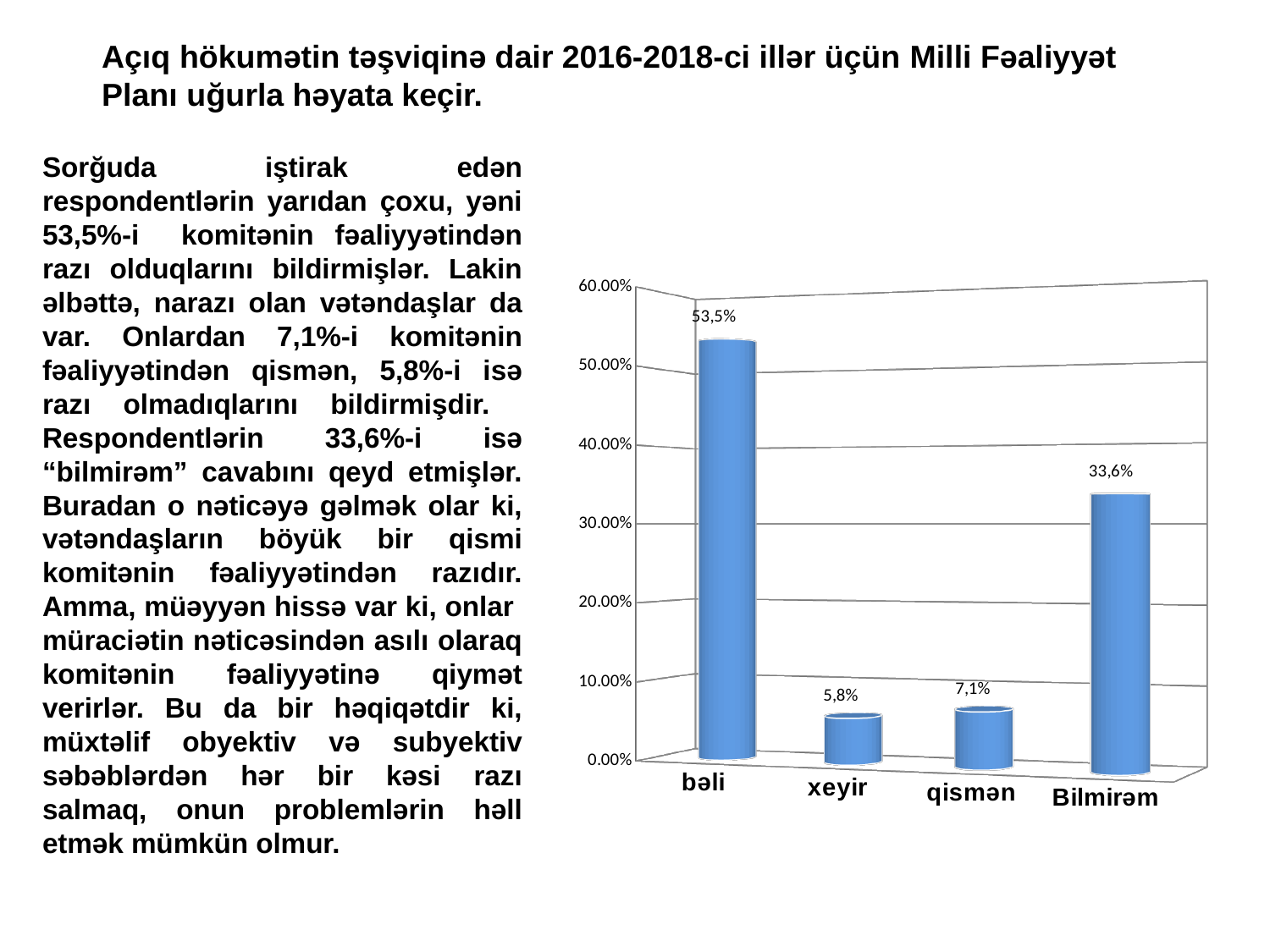
Which category has the highest value? bəli What colour are the bars in the chart? blue What is the value for bəli? 53,5% What kind of chart is shown on the slide? bar chart What is the value for Bilmirəm? 33,6% What is the value for xeyir? 5,8% What is the value for qismən? 7,1% Is the value for Bilmirəm greater or less than 30.00%? greater Which category has the lowest value? xeyir What is the difference between the values for bəli and Bilmirəm? 19,9% How many categories are shown on the x axis? 4 Which is larger, the value for qismən or the value for xeyir? qismən